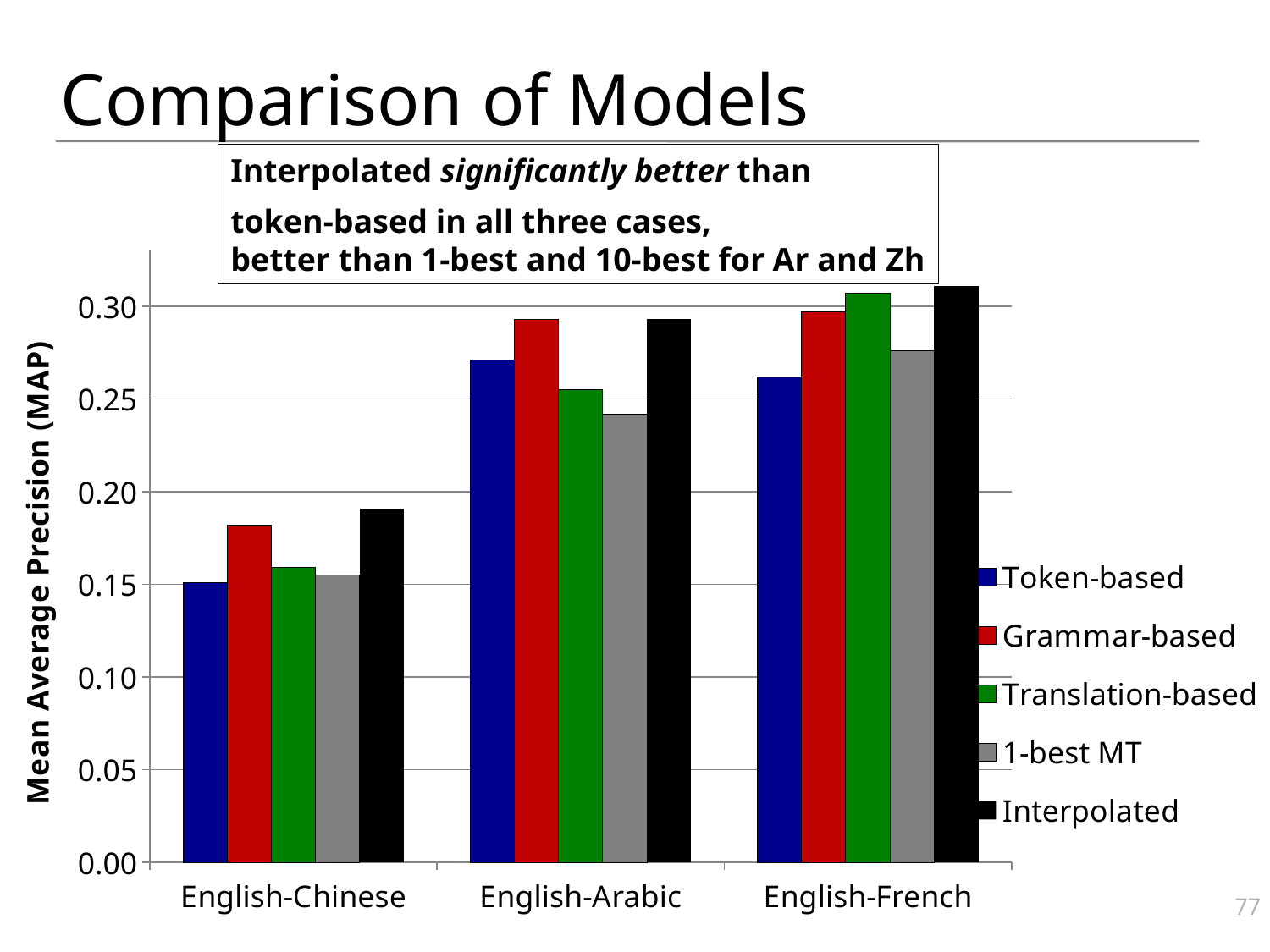
How many series does the legend list? 5 For English-Chinese, which series has the highest MAP? Interpolated For English-Chinese, which is larger: Grammar-based or Token-based? Grammar-based Is the Token-based value for English-Chinese greater or less than 0.20? less What kind of chart is shown on the slide? bar chart Is the Interpolated value for English-French greater or less than 0.30? greater For English-Arabic, which series has the lowest MAP? 1-best MT What is the label on the y axis? Mean Average Precision (MAP) How many language-pair categories are shown on the x axis? 3 For English-French, which series has the lowest MAP? Token-based Do the Interpolated values rise or fall from English-Chinese to English-Arabic? rise Is the Grammar-based value for English-Arabic greater or less than 0.25? greater